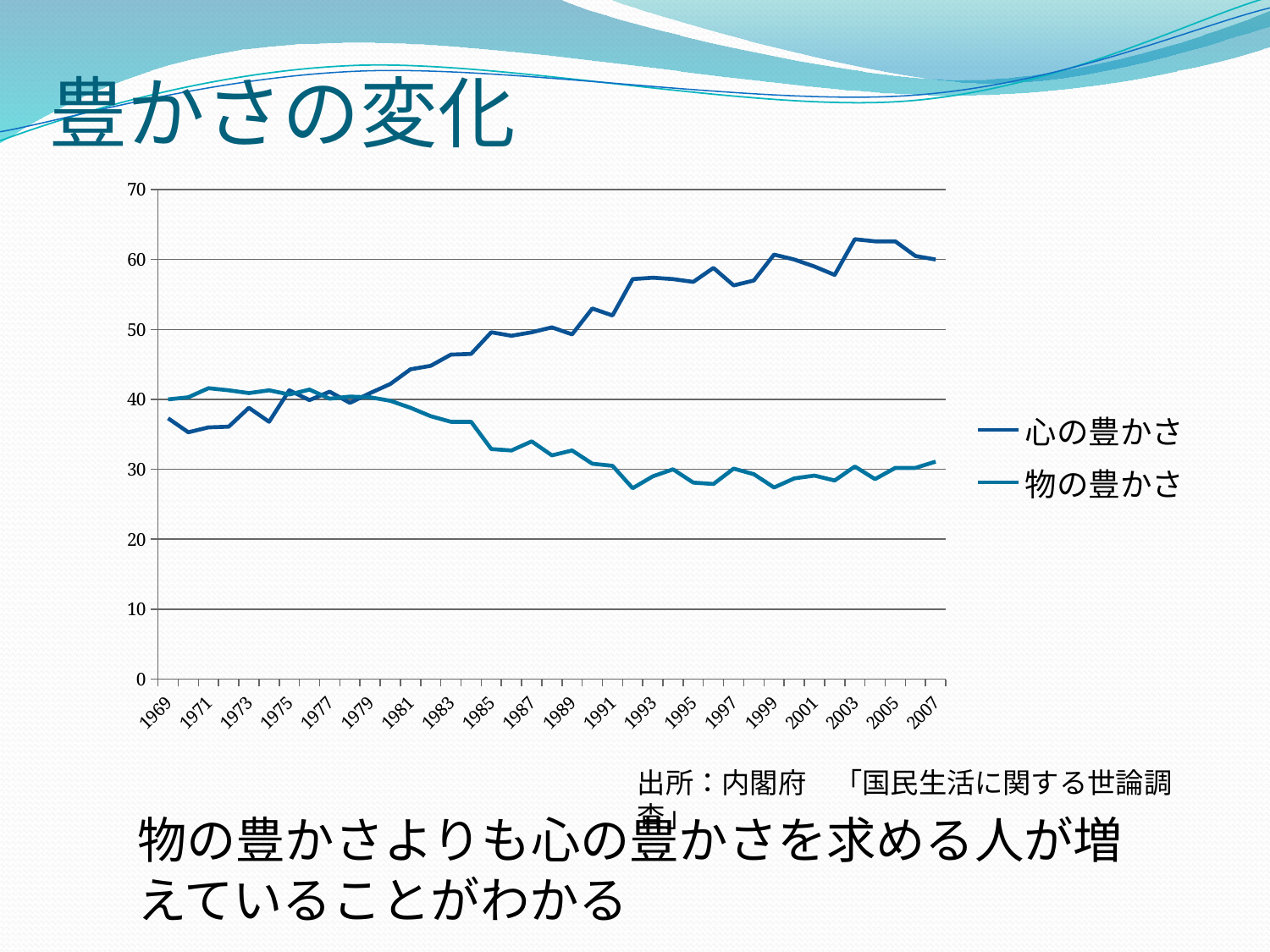
Is the value for 心の豊かさ in 1969 greater or less than 40? less Does the 物の豊かさ line generally rise or fall from 1969 to 2007? fall What are the two series named in the legend? 心の豊かさ and 物の豊かさ In 2007, which series has the higher value, 心の豊かさ or 物の豊かさ? 心の豊かさ How many series does the legend list? 2 Is the value for 物の豊かさ in 1993 greater or less than 30? less In 1969, which series has the higher value, 心の豊かさ or 物の豊かさ? 物の豊かさ What kind of chart is shown on the slide? line chart Is the value for 心の豊かさ in 2003 greater or less than 60? greater Does the 心の豊かさ line generally rise or fall from 1969 to 2007? rise What is the highest value shown on the vertical axis? 70